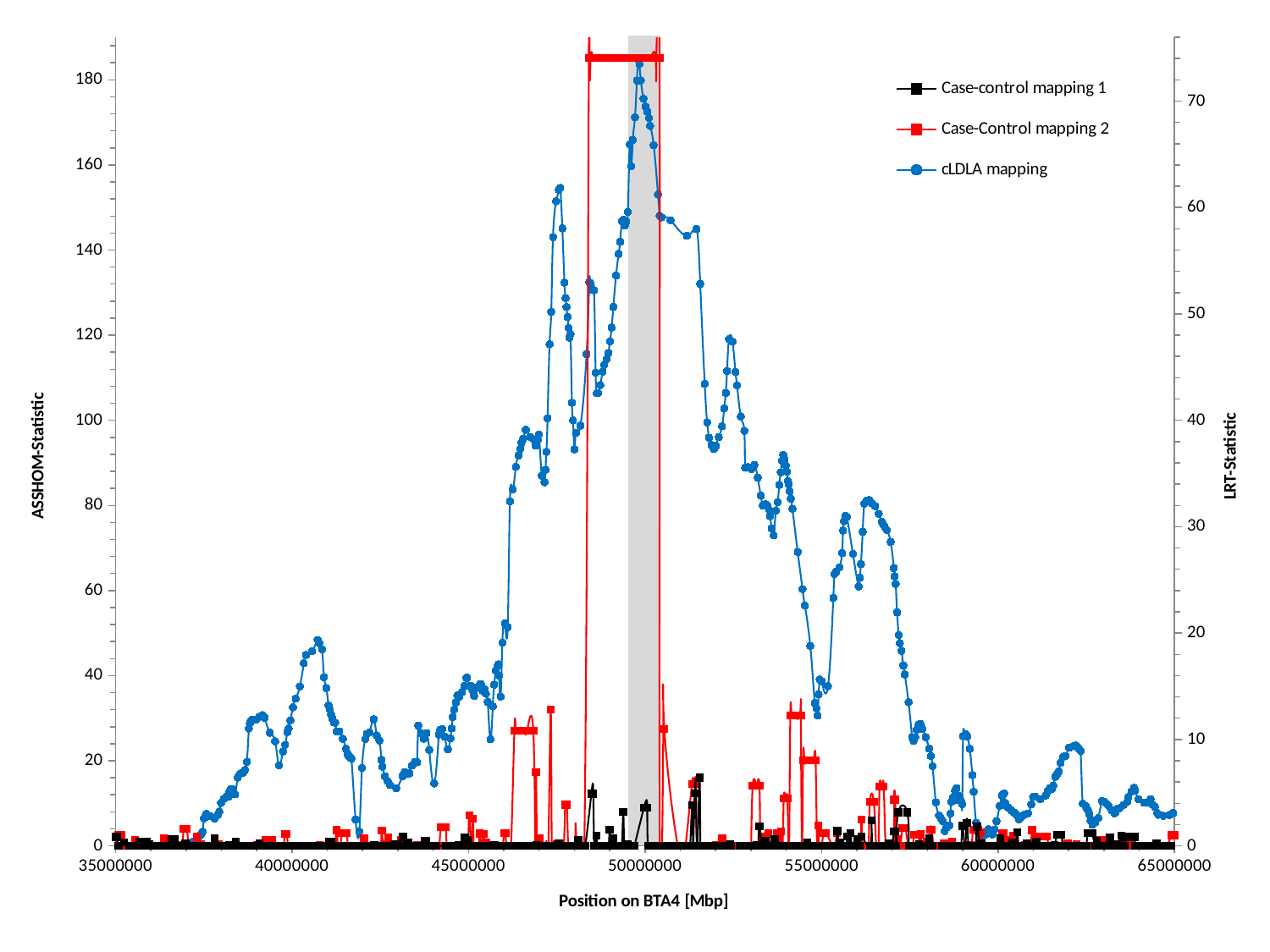
Which series reaches higher values on the left-hand axis, Case-control mapping 1 or Case-Control mapping 2? Case-Control mapping 2 Is the highest point of the Case-control mapping 1 series greater or less than 20 on the left-hand ASSHOM-Statistic axis? less Which series is drawn in blue with circle markers? cLDLA mapping Is the highest point of the cLDLA mapping line greater or less than 60 on the right-hand LRT-Statistic axis? greater Does the cLDLA mapping line rise or fall between positions 35000000 and 40000000? rise What kind of chart is shown on the slide? line chart Is the highest point of the Case-Control mapping 2 series greater or less than 160 on the left-hand ASSHOM-Statistic axis? greater What is the title of the x axis? Position on BTA4 [Mbp] How many series does the legend list? 3 What is the title of the left-hand y axis? ASSHOM-Statistic Does the cLDLA mapping line overall rise or fall between positions 55000000 and 60000000? fall